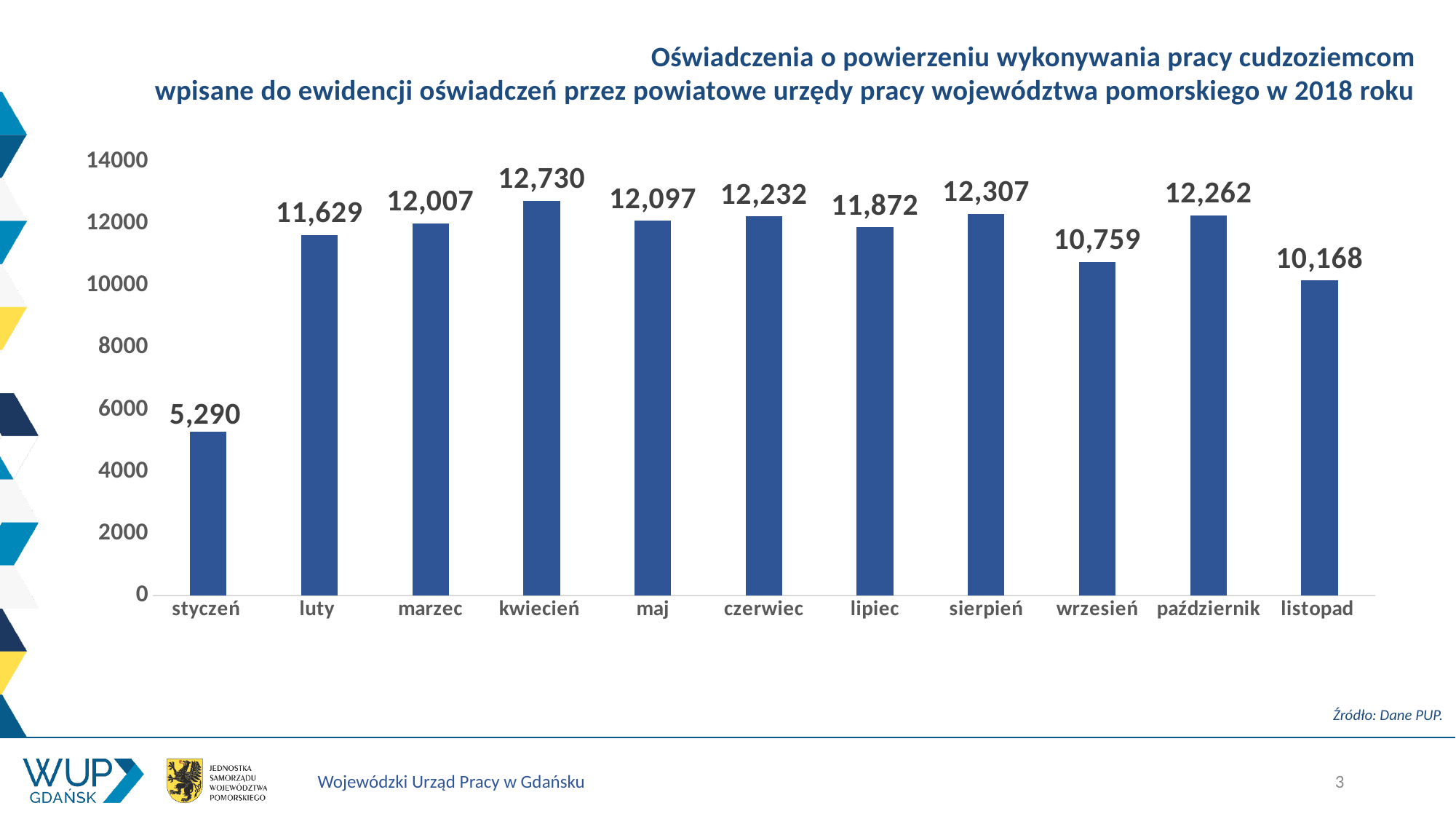
Which month has the lowest value? styczeń Which month has the highest value? kwiecień What is the difference between the values for październik and listopad? 2,094 How many months are shown on the chart? 11 Which is larger, the value for sierpień or the value for lipiec? sierpień What is the difference between the values for kwiecień and styczeń? 7,440 What is the value for wrzesień? 10,759 What is the value for kwiecień? 12,730 What is the value for styczeń? 5,290 What kind of chart is shown on the slide? bar chart Is the value for listopad greater or less than 12000? less What is the source given for the chart data? Dane PUP